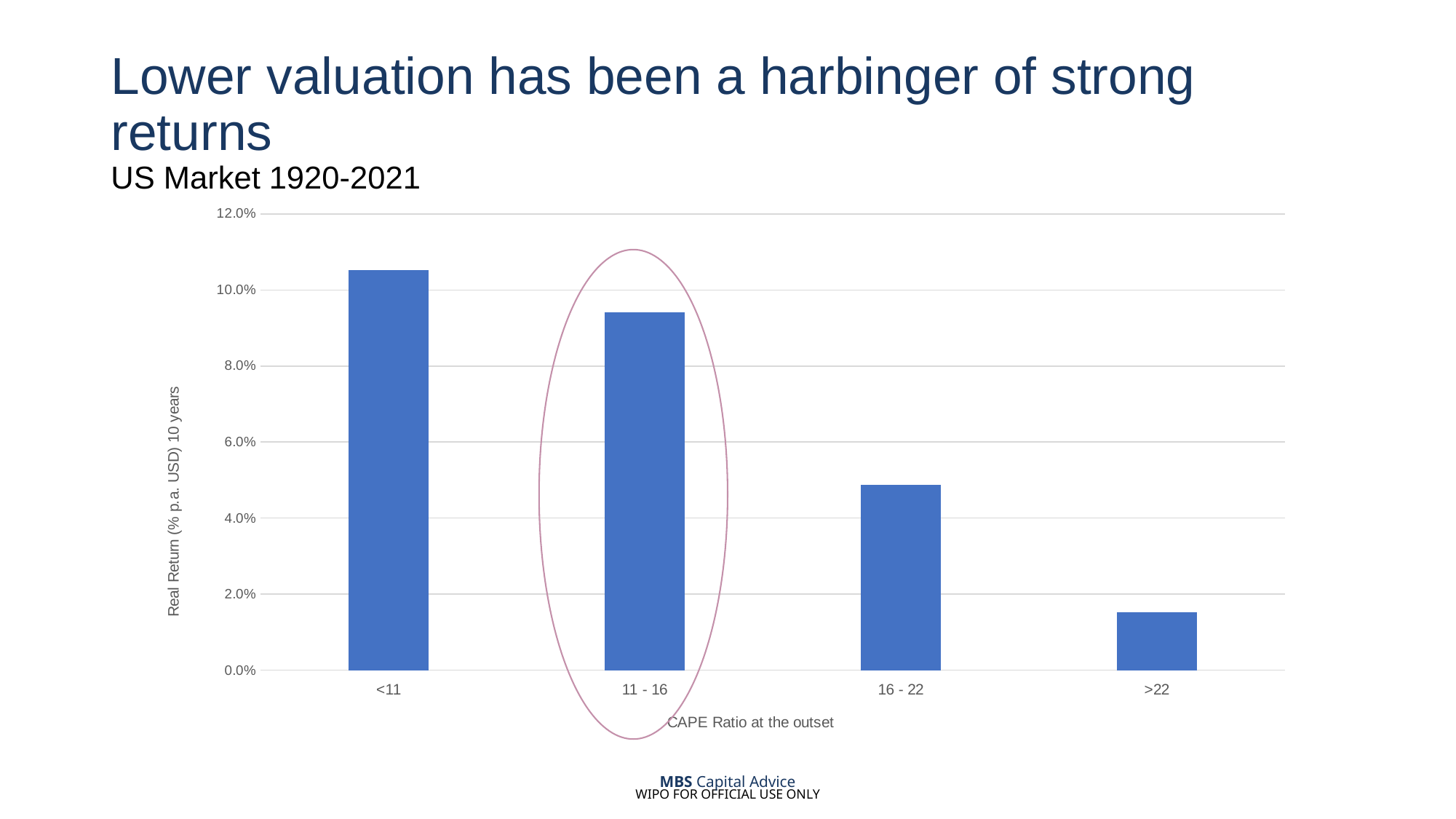
Is the real return for the 11 - 16 category greater or less than 10.0%? less Which CAPE ratio category has the lowest real return? >22 Is the real return for the <11 category greater or less than 10.0%? greater Which CAPE ratio category has the highest real return? <11 What is the label of the x axis? CAPE Ratio at the outset Is the real return for the >22 category greater or less than 2.0%? less How many CAPE ratio categories are plotted on the x axis? 4 Do the real returns rise or fall as the CAPE ratio category increases along the x axis? Fall Which bar is highlighted with an oval outline? 11 - 16 What kind of chart is shown on the slide? Bar chart Which has the larger real return, the 11 - 16 category or the 16 - 22 category? 11 - 16